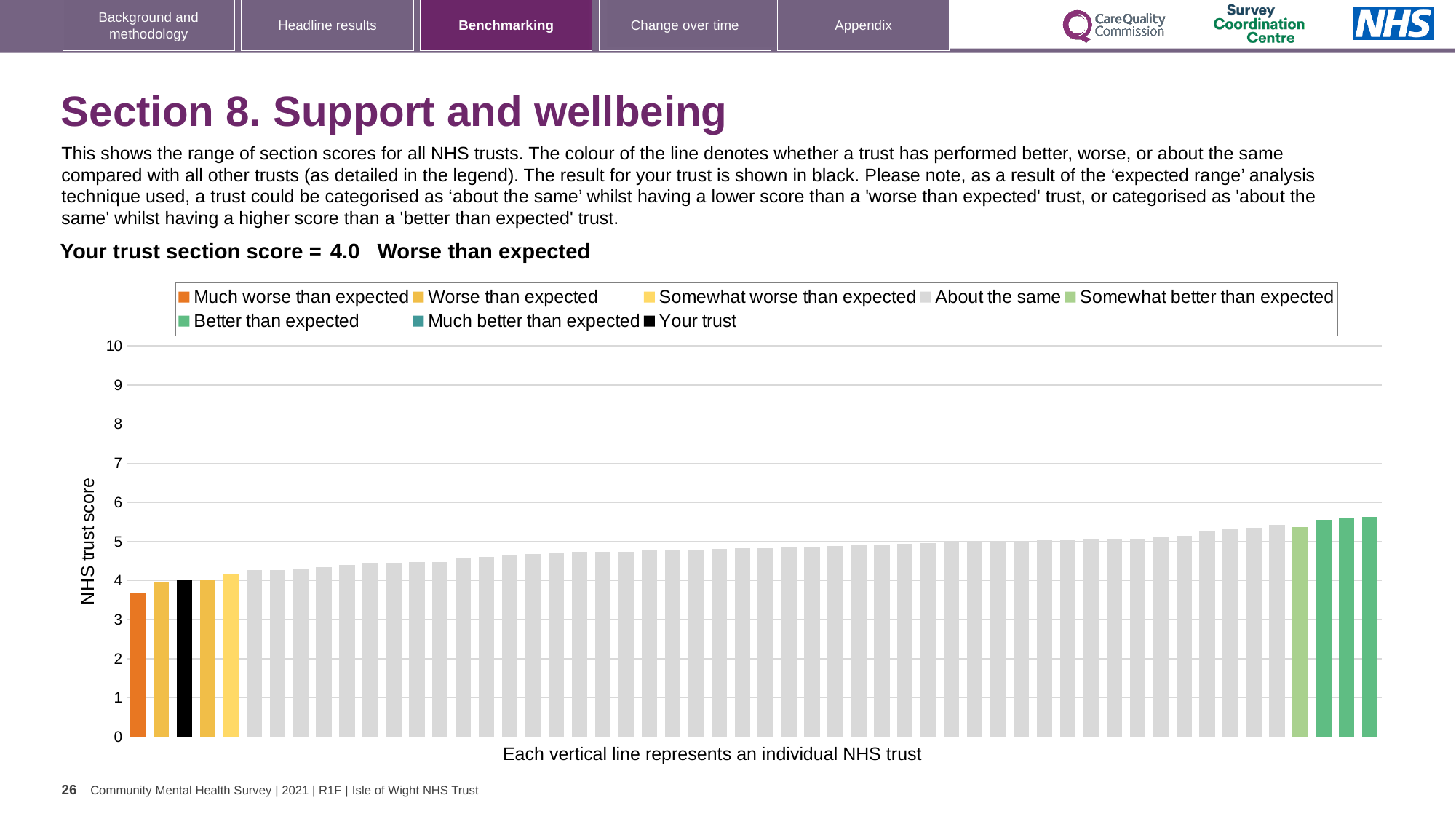
Which legend category does the lowest-scoring trust (the orange bar) belong to? Much worse than expected Is the value of the tallest bar greater or less than 5? greater Is the value for your trust (the black bar) greater or less than 5? less Do the bar values rise or fall from left to right along the x axis? rise What does the text below the x axis say each vertical line represents? an individual NHS trust How many bars on the chart are black? 1 What is the label on the vertical axis of the chart? NHS trust score Is the value of the shortest bar (the orange bar) greater or less than 4? less How is your trust's section score categorised on the slide? Worse than expected What is the section score for your trust shown on the slide? 4.0 How many entries does the chart legend list? 8 What kind of chart is shown on the slide? bar chart